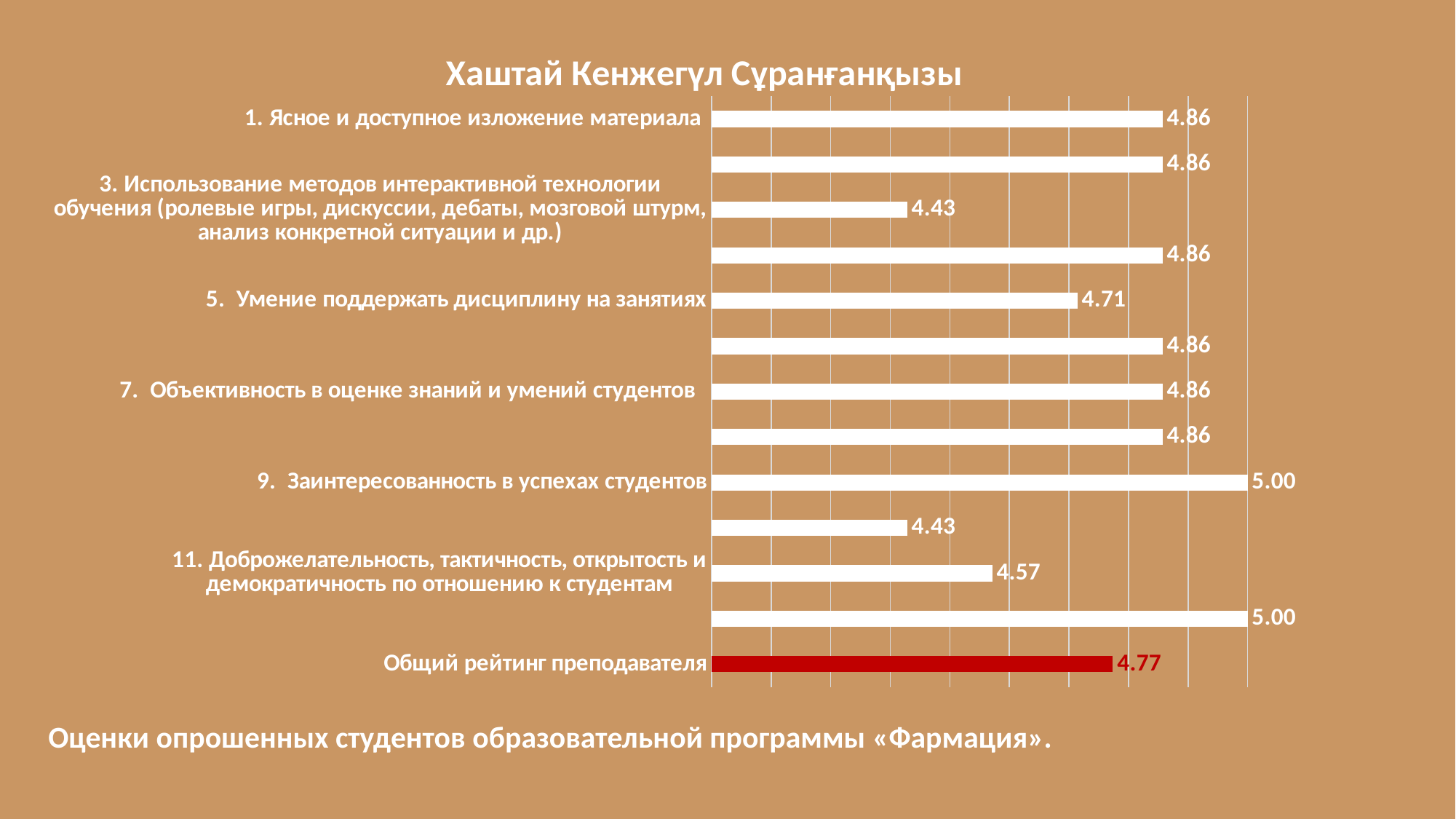
What is the value for "1. Ясное и доступное изложение материала"? 4.86 What colour is the bar for "Общий рейтинг преподавателя"? Red What is the value for "3. Использование методов интерактивной технологии обучения"? 4.43 What is the difference between the value for "9. Заинтересованность в успехах студентов" and the value for "11. Доброжелательность, тактичность, открытость и демократичность по отношению к студентам"? 0.43 How many bars are plotted on the chart? 13 What is the highest value shown on the chart? 5.00 Which has the larger value: "5. Умение поддержать дисциплину на занятиях" or "7. Объективность в оценке знаний и умений студентов"? 7. Объективность в оценке знаний и умений студентов What kind of chart is shown on the slide? Bar chart What is the value for "9. Заинтересованность в успехах студентов"? 5.00 What is the value for "Общий рейтинг преподавателя"? 4.77 What is the value for "5. Умение поддержать дисциплину на занятиях"? 4.71 What is the value for "11. Доброжелательность, тактичность, открытость и демократичность по отношению к студентам"? 4.57